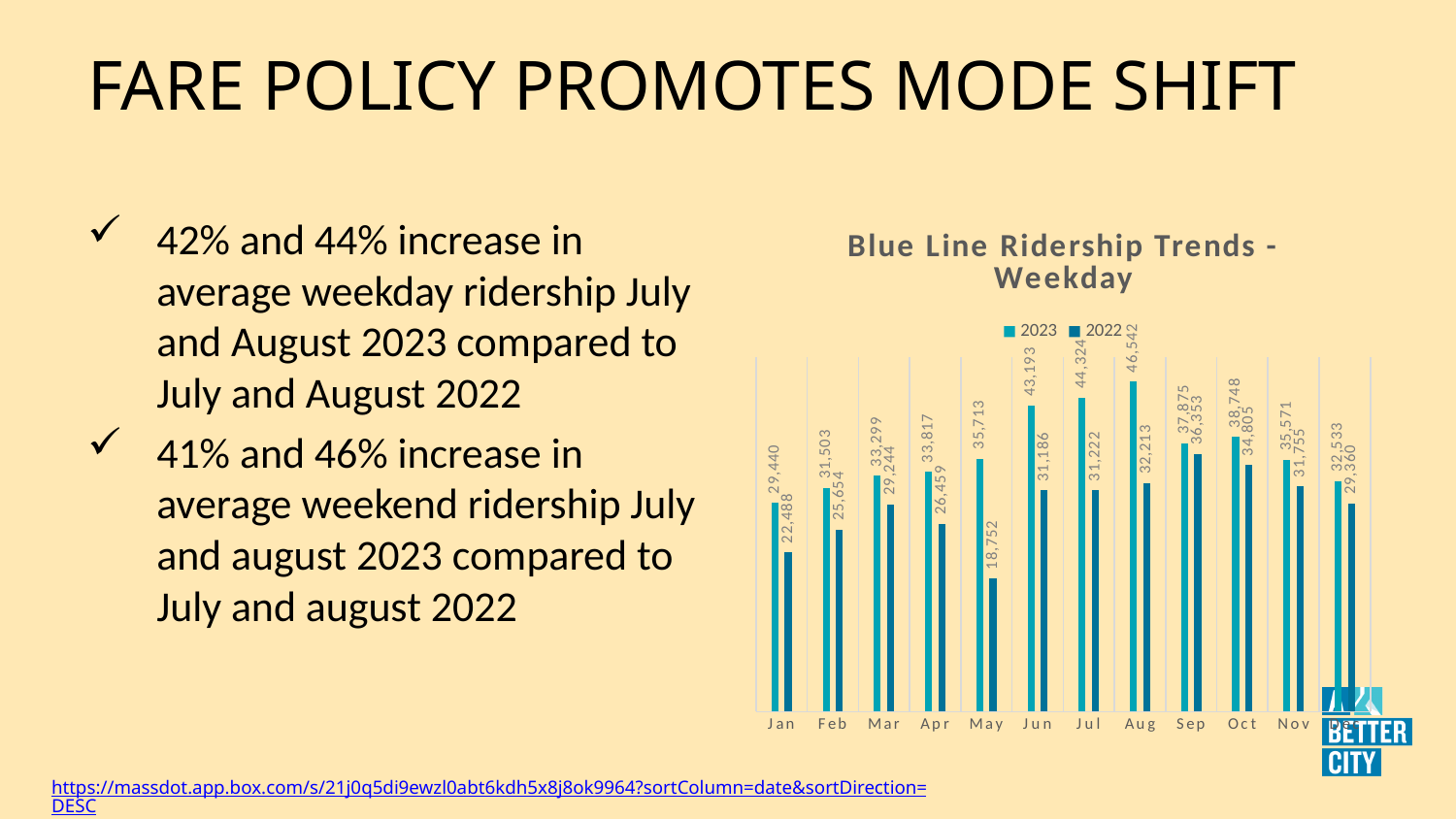
What is the 2023 weekday ridership value for Aug in the Blue Line Ridership Trends - Weekday chart? 46,542 What is the 2022 value for Oct in the chart? 34,805 What is the difference between the 2023 and 2022 values for Aug? 14,329 Which month has the lowest 2022 value in the chart? May What kind of chart is shown on the slide? Bar chart What is the difference between the 2023 and 2022 values for Jan? 6,952 Do the 2023 values rise or fall from Jan to Aug? Rise What is the title of the chart on the slide? Blue Line Ridership Trends - Weekday What is the 2022 value for May in the Blue Line Ridership Trends - Weekday chart? 18,752 How many series does the legend of the chart list? 2 Which month has the highest 2023 value in the chart? Aug For Sep, which series has the larger value, 2023 or 2022? 2023